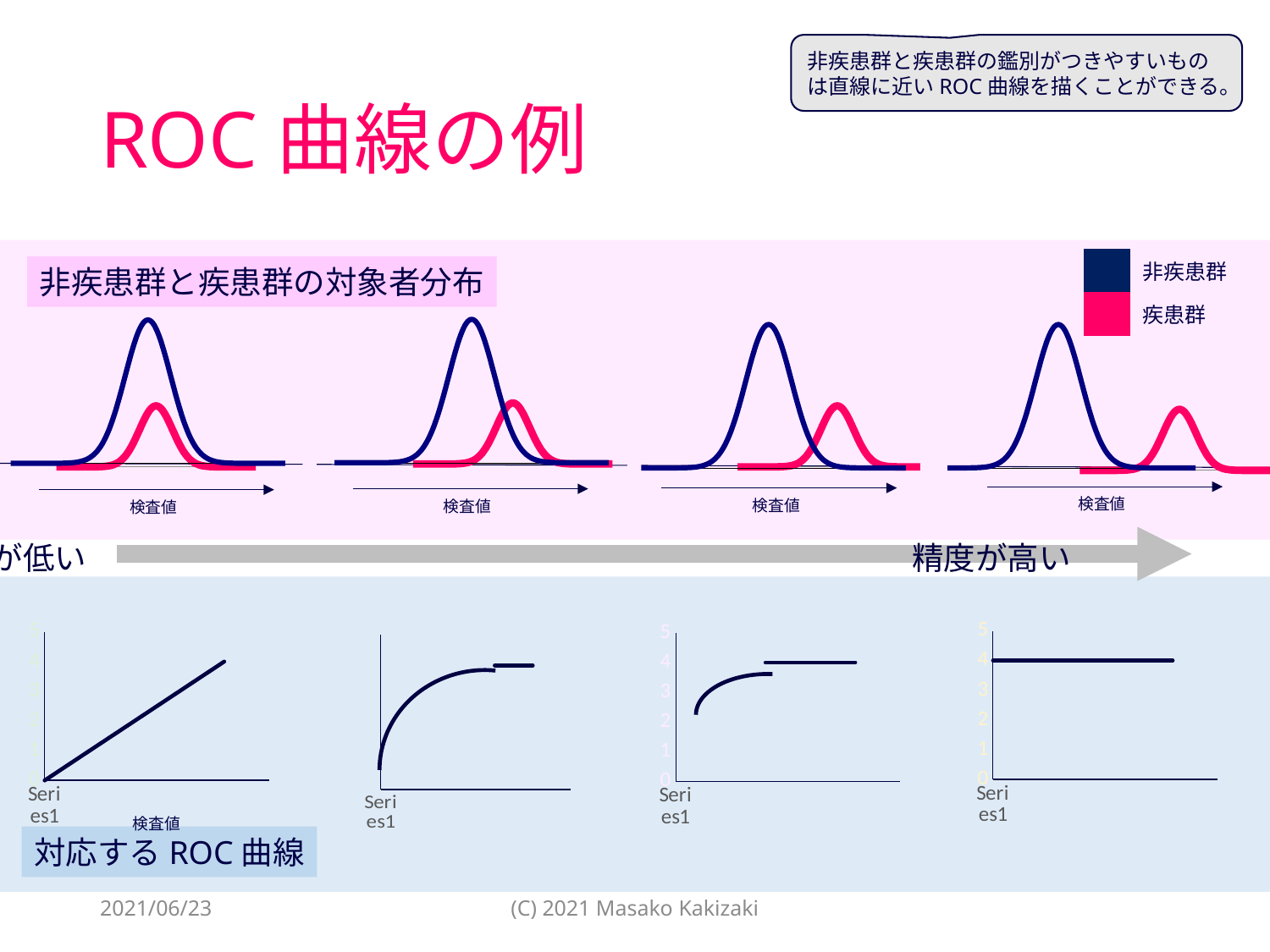
In the rightmost ROC curve chart, is the plotted line greater or less than 2 on the vertical axis? greater In the leftmost ROC curve chart, does the curve rise or fall as it moves along the x axis? rise How many distribution charts (非疾患群と疾患群の対象者分布) are shown in the upper row? 4 In the rightmost distribution chart, which group has the lower peak, 非疾患群 or 疾患群? 疾患群 What kind of chart are the four ROC curves in the lower row of the slide? line chart How many ROC curve charts (対応する ROC 曲線) are shown in the lower row? 4 In the leftmost distribution chart, which group has the higher peak, 非疾患群 or 疾患群? 非疾患群 How many entries does the legend at the top right of the distribution charts list? 2 What is the x-axis label shown under each distribution chart? 検査値 What colour is used for 疾患群 in the legend of the distribution charts? pink In the third ROC curve chart from the left, is the starting point of the curve greater or less than 1 on the vertical axis? greater